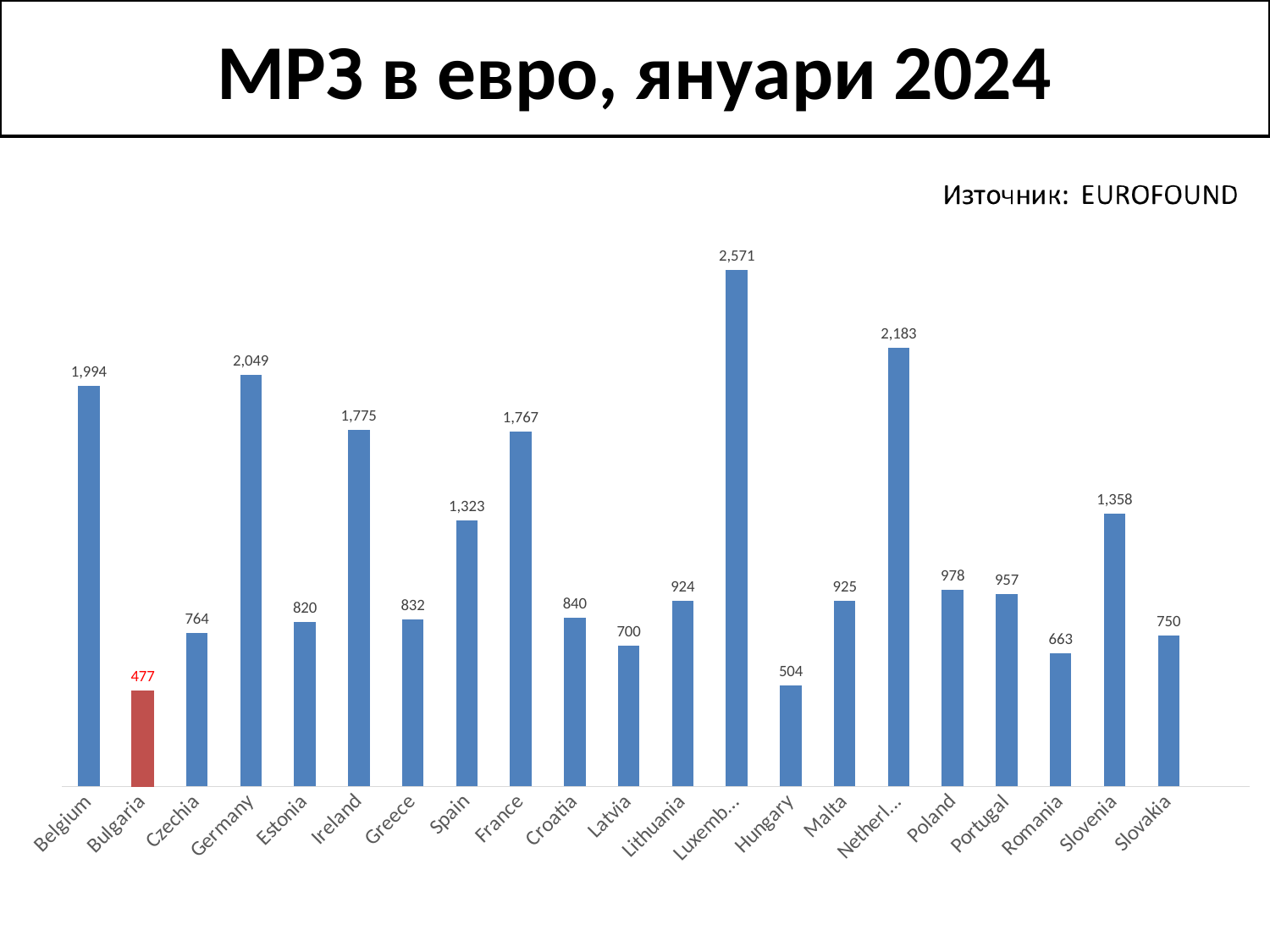
What is the value for Hungary? 504 Which country has the lowest value? Bulgaria What is the value for Germany? 2,049 Which country has the highest value? Luxembourg What kind of chart is shown on the slide? Bar chart How many countries are shown on the chart? 21 What is the value for Slovenia? 1,358 Which is larger, the value for Spain or the value for Poland? Spain Which bar is coloured differently (red) from the others? Bulgaria What is the difference between the values for Germany and Belgium? 55 What is the value for Bulgaria? 477 What is the difference between the values for Czechia and Bulgaria? 287